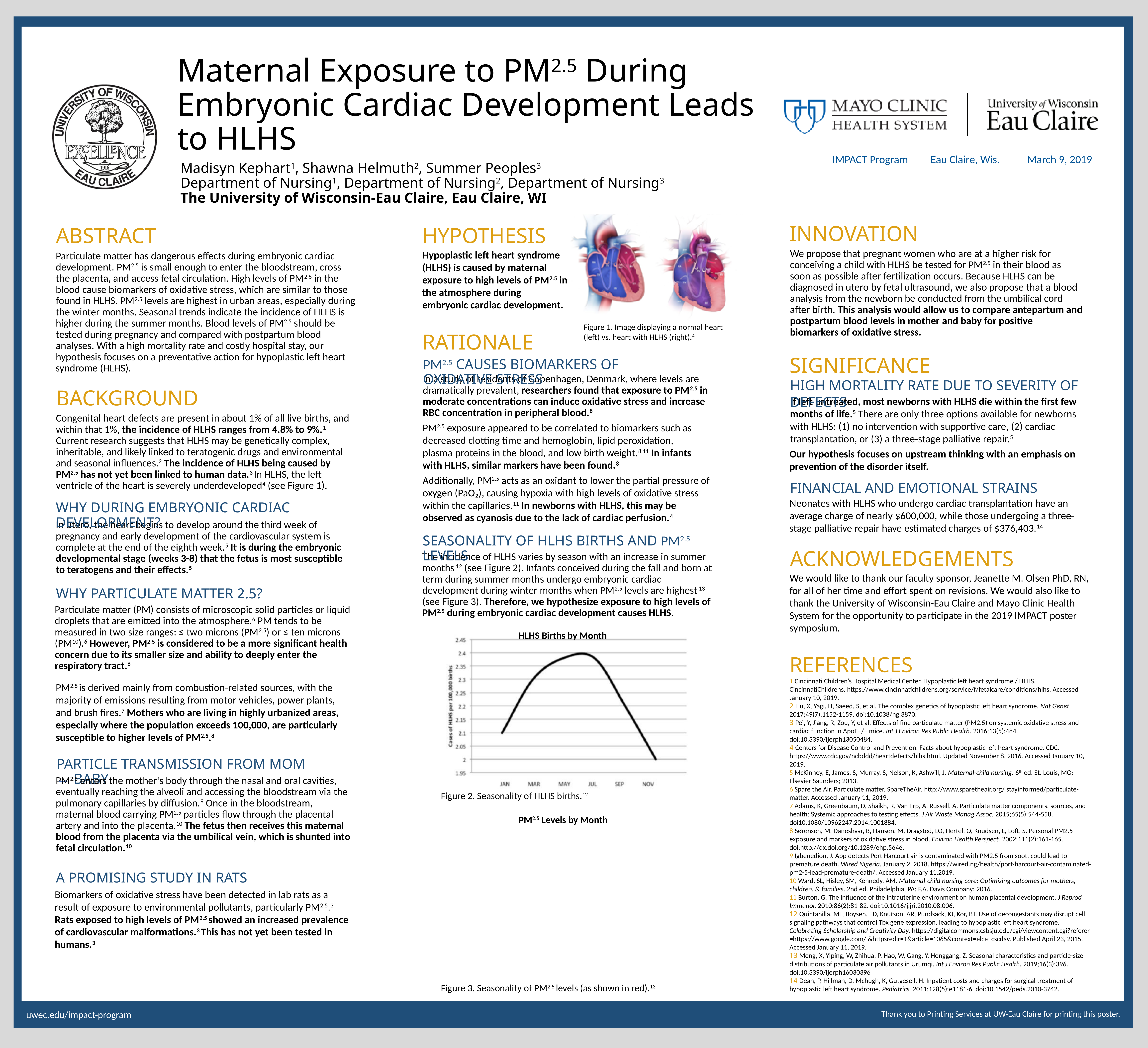
In the "HLHS Births by Month" chart, which labeled month has the lowest value? NOV In the "HLHS Births by Month" chart, is the value for MAY greater or less than 2.3? greater What kind of chart is the "HLHS Births by Month" chart? line chart How many month labels are shown on the x axis of the "HLHS Births by Month" chart? 6 What is the title of the chart in Figure 2? HLHS Births by Month In the "HLHS Births by Month" chart, is the value for JAN greater or less than 2.2? less In the "HLHS Births by Month" chart, do the values rise or fall from JUL to NOV? fall In the "HLHS Births by Month" chart, which is larger, the value for JUL or the value for JAN? JUL In the "HLHS Births by Month" chart, is the value for JUL greater or less than 2.3? greater How many lines are plotted on the "HLHS Births by Month" chart? 1 What is the y-axis label of the "HLHS Births by Month" chart? Cases of HLHS per 100,000 births